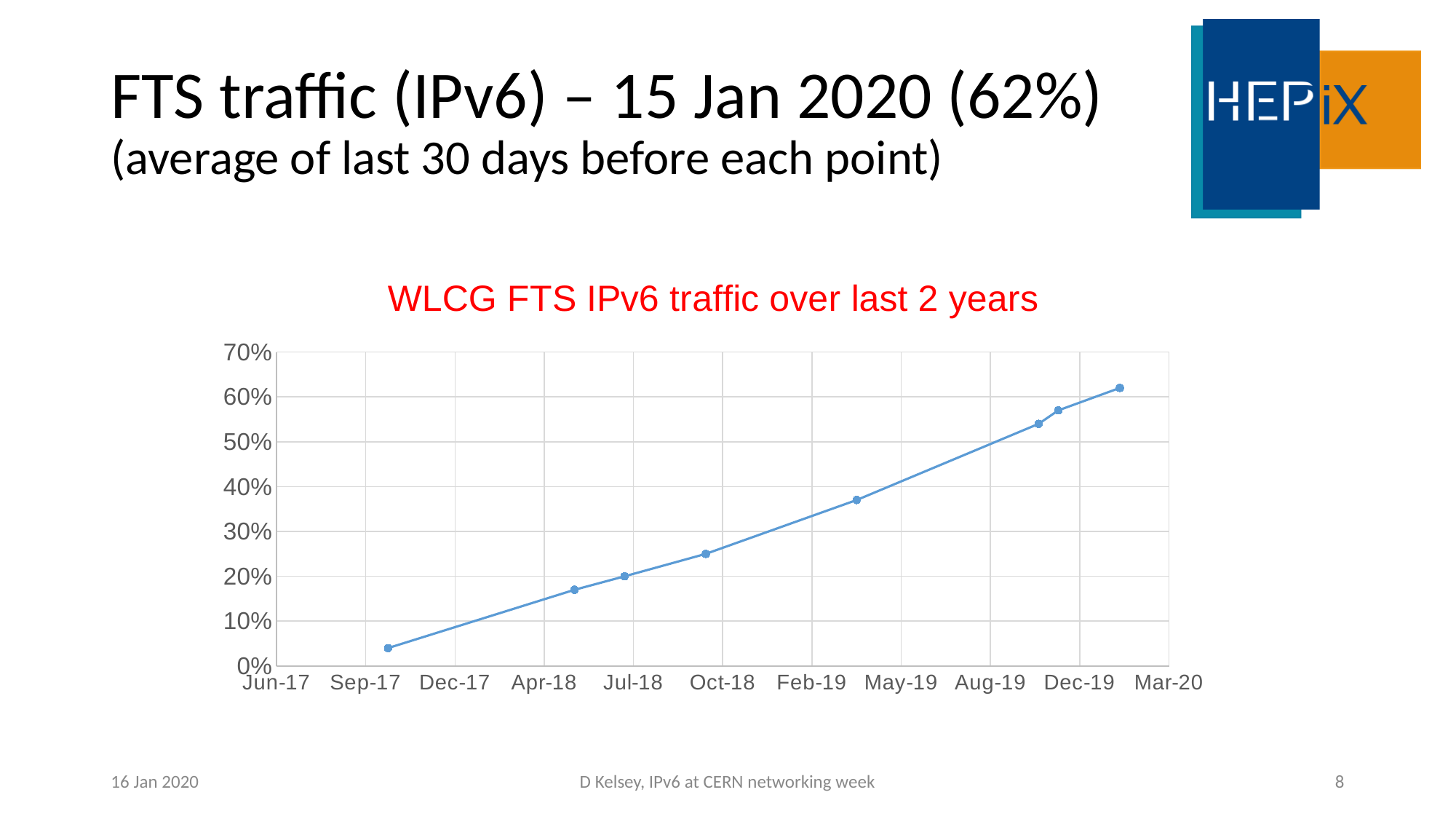
Is the value of the data point near Apr-19 greater or less than 40%? less How many data points are plotted on the line? 8 What is the highest value shown on the y axis? 70% Is the value of the data point near Nov-19 greater or less than 50%? greater Which data point has the highest value? the last point (Jan 2020) Is the value of the data point near Apr-19 greater or less than 30%? greater Which data point has the lowest value? the first point (Sep-17) Do the values rise or fall over time along the x axis? rise What kind of chart is shown on the slide? line chart What is the title of the chart? WLCG FTS IPv6 traffic over last 2 years